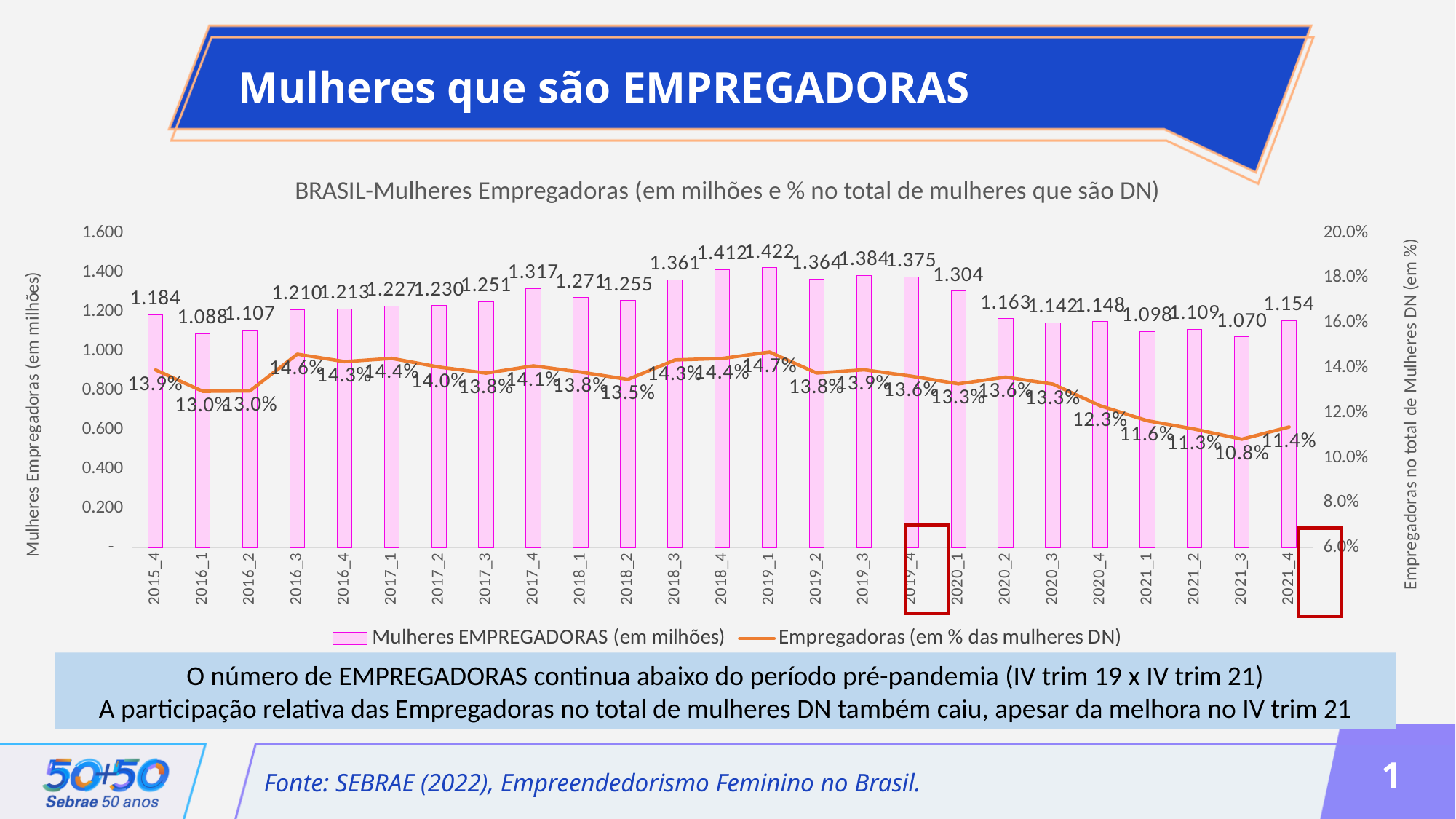
Which is larger: the Mulheres EMPREGADORAS (em milhões) value for 2015_4 or for 2021_4? 2015_4 What kind of chart is used to show Mulheres EMPREGADORAS (em milhões)? Bar chart What is the title of the chart? BRASIL-Mulheres Empregadoras (em milhões e % no total de mulheres que são DN) How many series does the chart legend list? 2 What is the difference between the Mulheres EMPREGADORAS (em milhões) values for 2019_4 and 2021_4? 0.221 What is the value of Empregadoras (em % das mulheres DN) for 2021_3? 10.8% Which quarter has the highest value of Empregadoras (em % das mulheres DN)? 2019_1 Does the Empregadoras (em % das mulheres DN) line rise or fall from 2019_1 to 2021_3? Fall How many quarters are shown on the x axis of the chart? 25 Which quarter has the highest value of Mulheres EMPREGADORAS (em milhões)? 2019_1 Which quarter has the lowest value of Mulheres EMPREGADORAS (em milhões)? 2021_3 What is the value of Mulheres EMPREGADORAS (em milhões) for 2019_1? 1.422